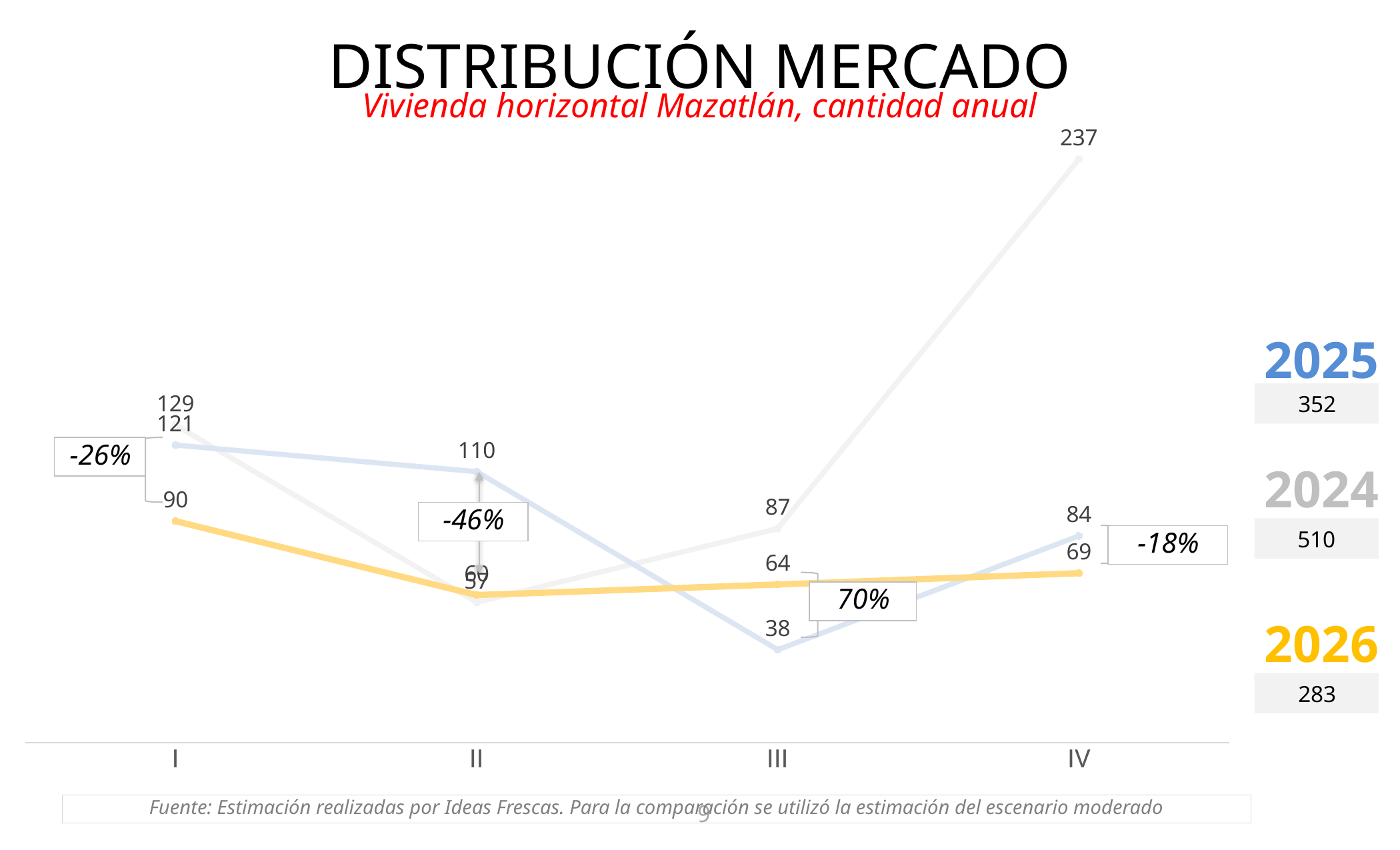
What is the difference between the 2024 and 2025 values in quarter IV? 153 In which quarter is the 2025 value lowest? III How many series (years) does the chart show? 3 What annual total is shown for 2024? 510 In which quarter is the 2024 value highest? IV How many quarters are shown on the x axis? 4 Which is larger in quarter I, the 2025 value or the 2026 value? 2025 What is the value for 2025 in quarter III? 38 What is the value for 2026 in quarter I? 90 What kind of chart is shown on the slide? line chart What is the value for 2024 in quarter IV? 237 What is the value for 2025 in quarter II? 110